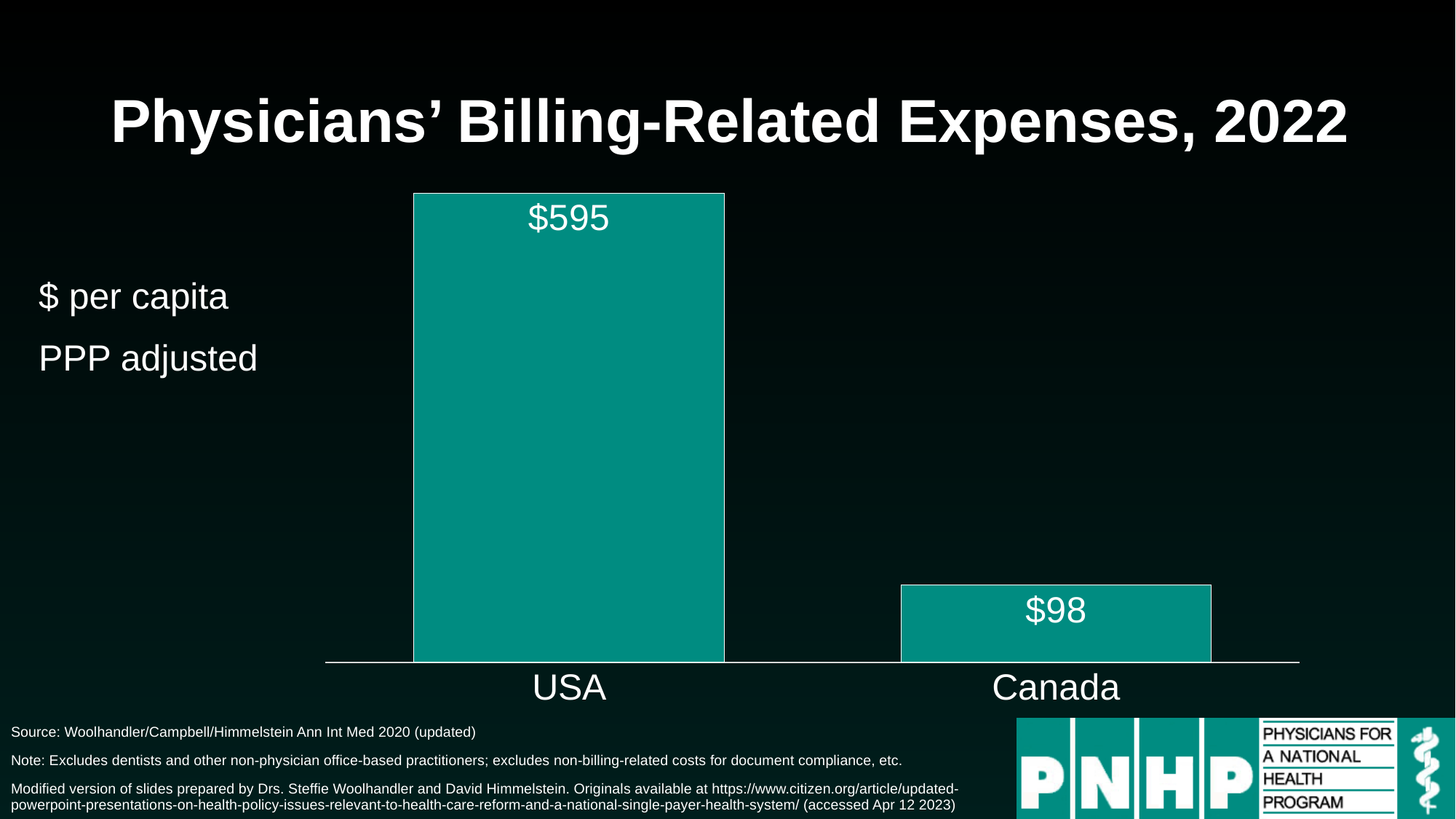
Which country has the highest billing-related expenses per capita? USA What unit are the values expressed in, according to the label on the left of the chart? $ per capita, PPP adjusted How many countries are shown in the chart? 2 What is the value for Canada? $98 What is the value for USA? $595 Which is larger, the value for USA or the value for Canada? USA What is the difference between the USA and Canada values? $497 Which country has the lowest billing-related expenses per capita? Canada What is the title of the slide? Physicians' Billing-Related Expenses, 2022 What kind of chart is shown on the slide? Bar chart